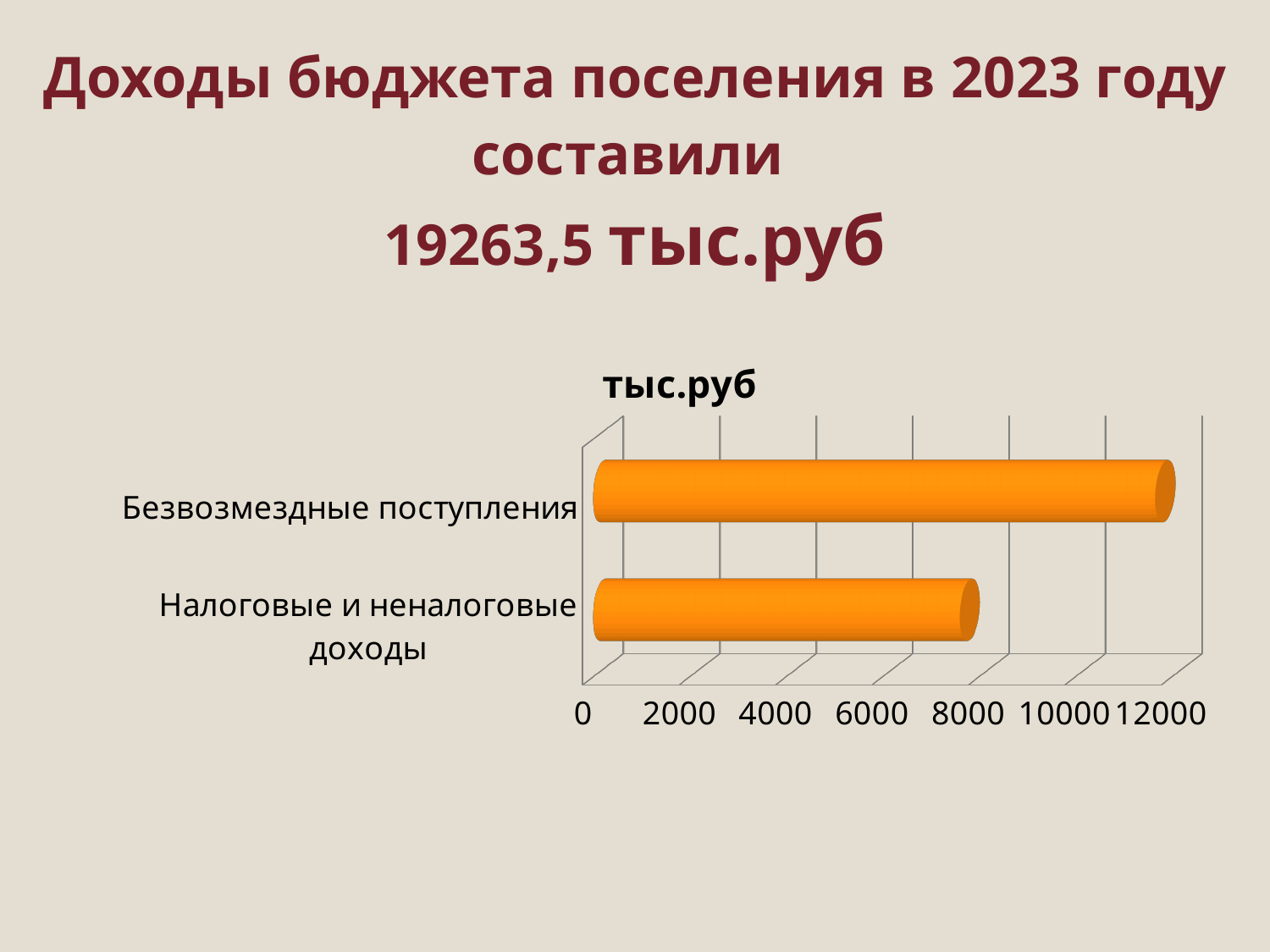
What kind of chart is shown on the slide? bar chart What colour are the bars in the chart? orange Is the value for Налоговые и неналоговые доходы greater or less than 6000? greater Is the value for Безвозмездные поступления greater or less than 10000? greater How many categories are plotted in the chart? 2 Is the value for Налоговые и неналоговые доходы greater or less than 10000? less Which is larger: the value for Безвозмездные поступления or the value for Налоговые и неналоговые доходы? Безвозмездные поступления Which category has the lowest value in the chart? Налоговые и неналоговые доходы What is the title of the chart? тыс.руб Which category has the highest value in the chart? Безвозмездные поступления